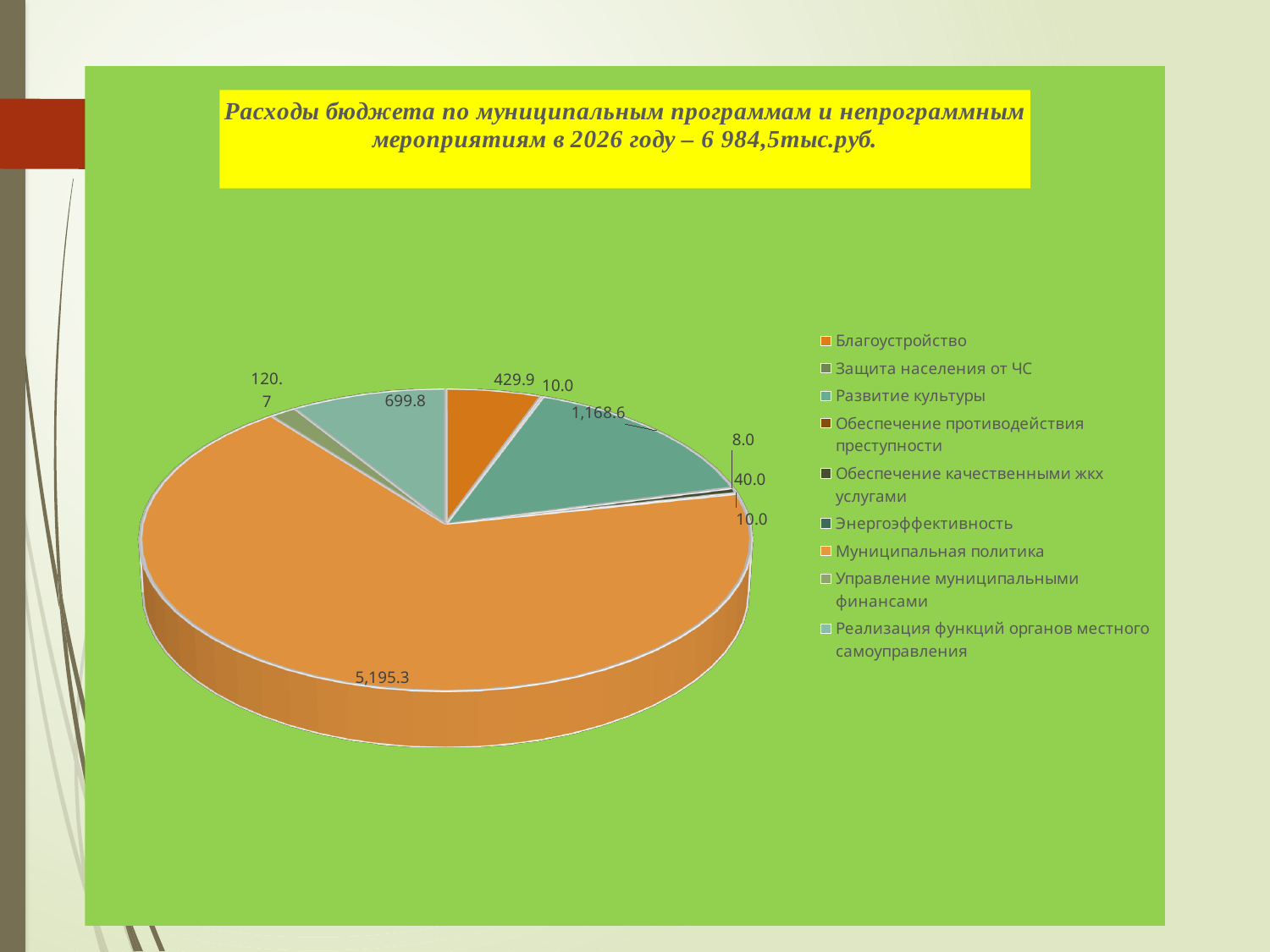
What kind of chart is shown on the slide? Pie chart What is the difference between the values for Развитие культуры and Реализация функций органов местного самоуправления? 468.8 What is the value shown for Реализация функций органов местного самоуправления? 699.8 What is the value shown for Муниципальная политика? 5,195.3 What is the value shown for Управление муниципальными финансами? 120.7 How many categories does the legend list? 9 What is the value shown for Благоустройство? 429.9 Which is larger: the value for Благоустройство or the value for Реализация функций органов местного самоуправления? Реализация функций органов местного самоуправления Which category has the largest slice of the pie? Муниципальная политика What is the value shown for Развитие культуры? 1,168.6 Which category has the smallest value? Обеспечение противодействия преступности What total amount is stated in the chart title for 2026? 6 984,5 тыс.руб.